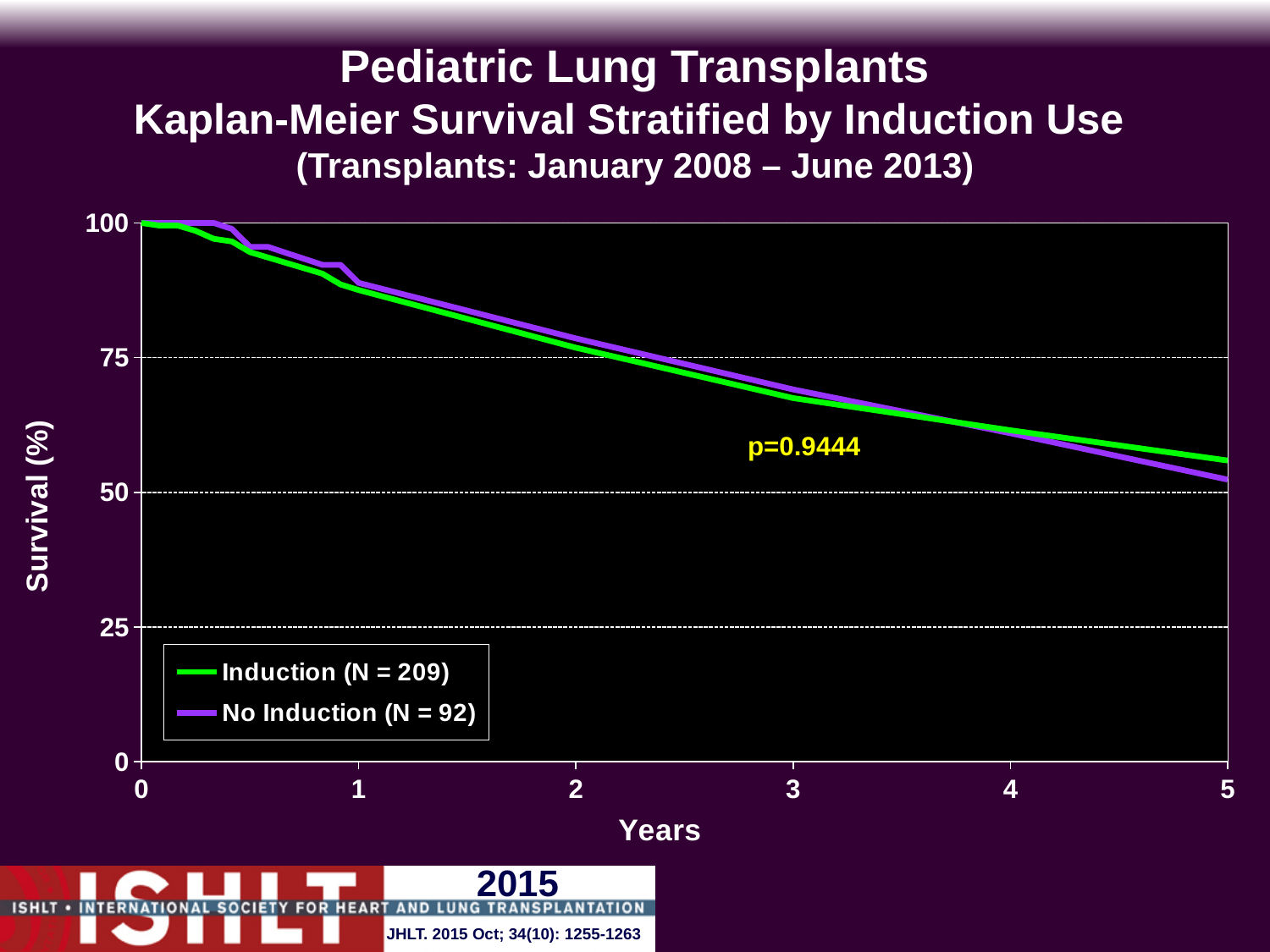
How many series does the legend list? 2 What p-value is printed on the chart? p=0.9444 What kind of chart is shown on the slide? line chart What is the N for the Induction group shown in the legend? 209 Is the survival value for the Induction group at 5 years greater or less than 50? greater What is the label of the y axis? Survival (%) Is the survival value for the Induction group at 3 years greater or less than 75? less Is the survival value for the No Induction group at 1 year greater or less than 75? greater At 1 year, which group has the higher survival, Induction or No Induction? No Induction Do the survival curves rise or fall as years increase? fall At 5 years, which group has the higher survival, Induction or No Induction? Induction